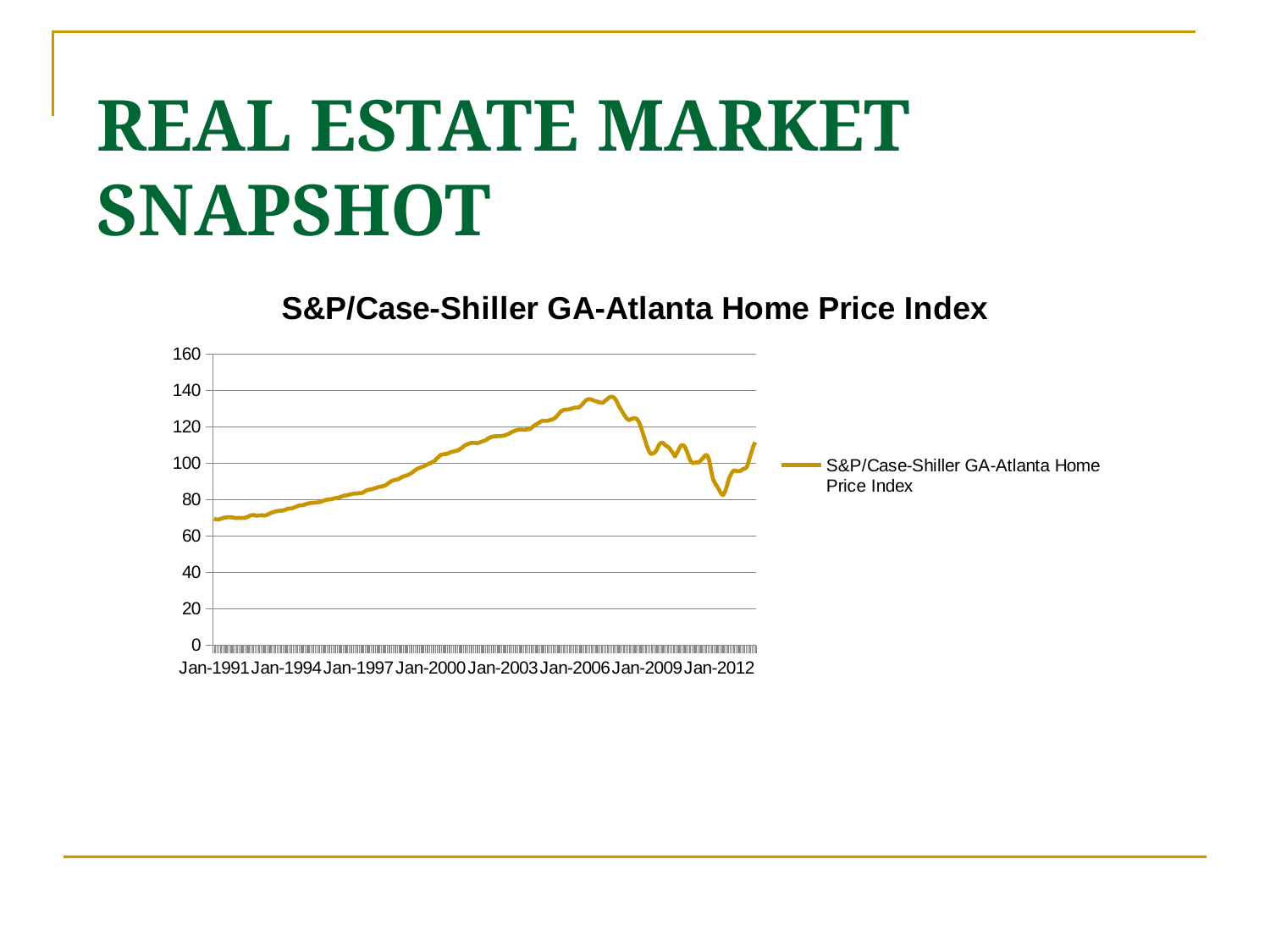
Does the index rise or fall between Jan-1991 and Jan-2006? rise What kind of chart is shown on the slide? line chart Is the peak value of the index greater or less than 140? less How many series does the legend list? 1 Which is larger, the value at Jan-2006 or the value at Jan-1994? Jan-2006 Is the value for Jan-1991 greater or less than 80? less Is the value for Jan-2003 greater or less than 100? greater Does the index rise or fall between Jan-2006 and Jan-2012? fall What is the title of the chart? S&P/Case-Shiller GA-Atlanta Home Price Index What is the highest value shown on the vertical axis? 160